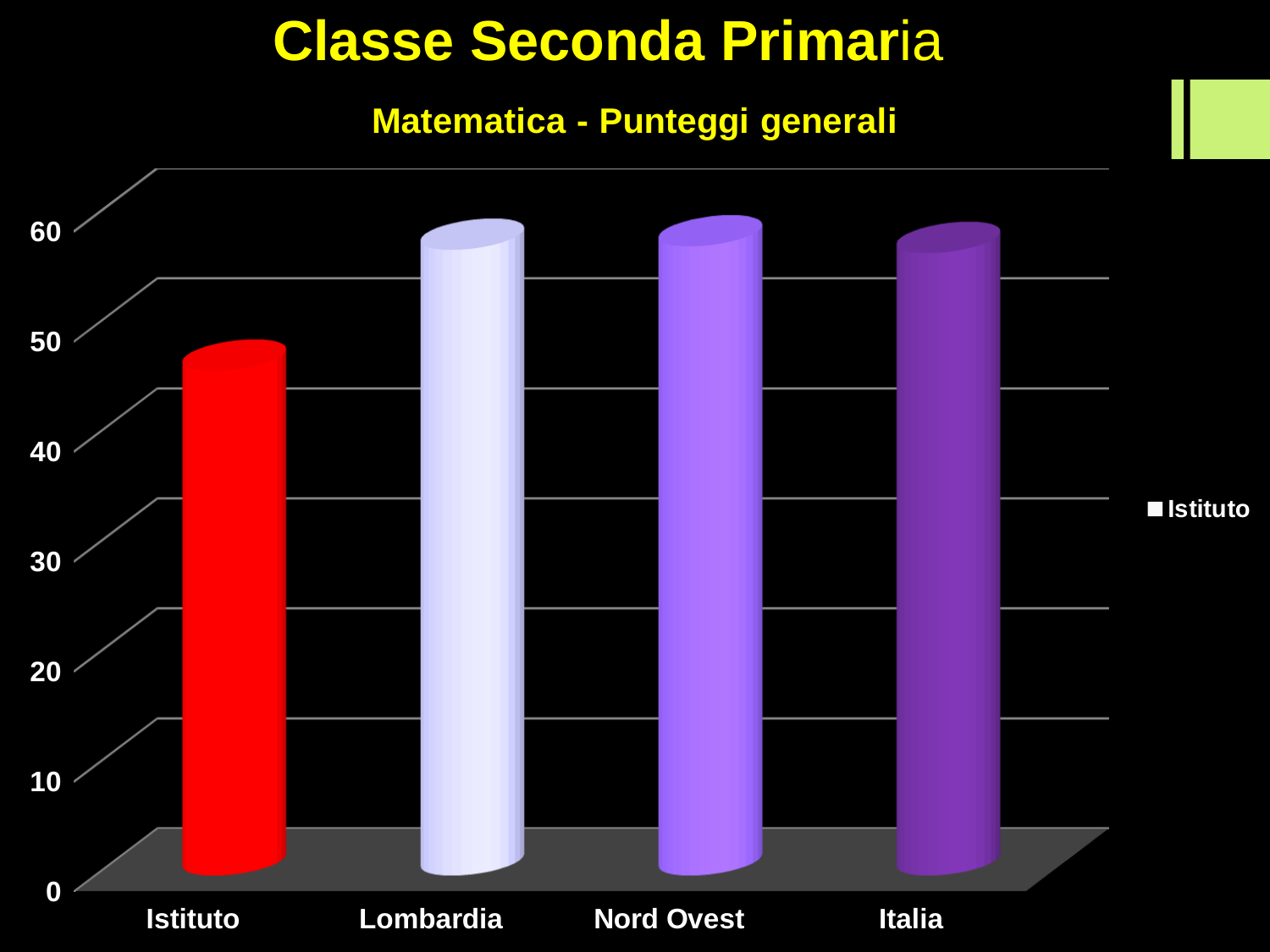
How many categories are shown on the x axis of the chart? 4 Which category has the lowest value in the chart? Istituto How many series does the chart legend list? 1 Is the value for Lombardia greater or less than 50? greater Is the value for Istituto greater or less than 40? greater Which is larger, the value for Istituto or the value for Lombardia? Lombardia Is the value for Istituto greater or less than 50? less What is the title of the chart? Matematica - Punteggi generali What colour is the bar for Istituto? red What kind of chart is shown on the slide? bar chart Which is larger, the value for Nord Ovest or the value for Istituto? Nord Ovest